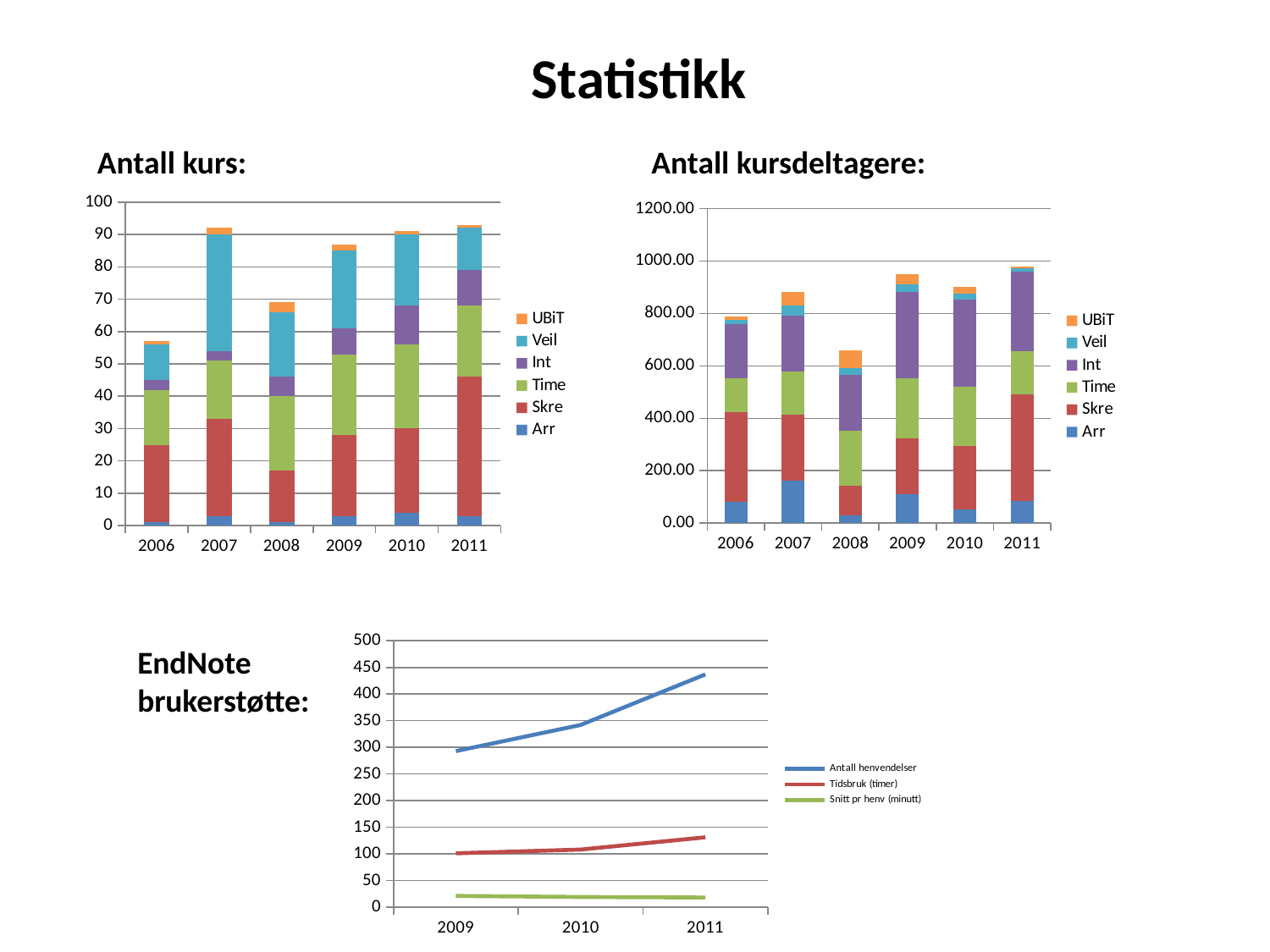
In the 'Antall kurs' chart, which year has the lowest total bar? 2006 In the 'Antall kurs' chart, is the total for 2006 greater or less than 50? greater How many years are shown on the x axis of the 'Antall kurs' chart? 6 How many series does the legend of the 'Antall kursdeltagere' chart list? 6 In the 'EndNote brukerstøtte' chart, is the value of 'Antall henvendelser' for 2011 greater or less than 400? greater In the 'EndNote brukerstøtte' chart, does the 'Antall henvendelser' line rise or fall from 2009 to 2011? rise What kind of chart is the 'EndNote brukerstøtte' chart at the bottom of the slide? line chart In the 'Antall kursdeltagere' chart, is the total for 2008 greater or less than 800.00? less What kind of chart is the 'Antall kurs' chart? stacked bar chart How many series does the legend of the 'EndNote brukerstøtte' chart list? 3 In the 'Antall kurs' chart, which total bar is larger, 2006 or 2007? 2007 In the 'Antall kursdeltagere' chart, which year has the lowest total bar? 2008